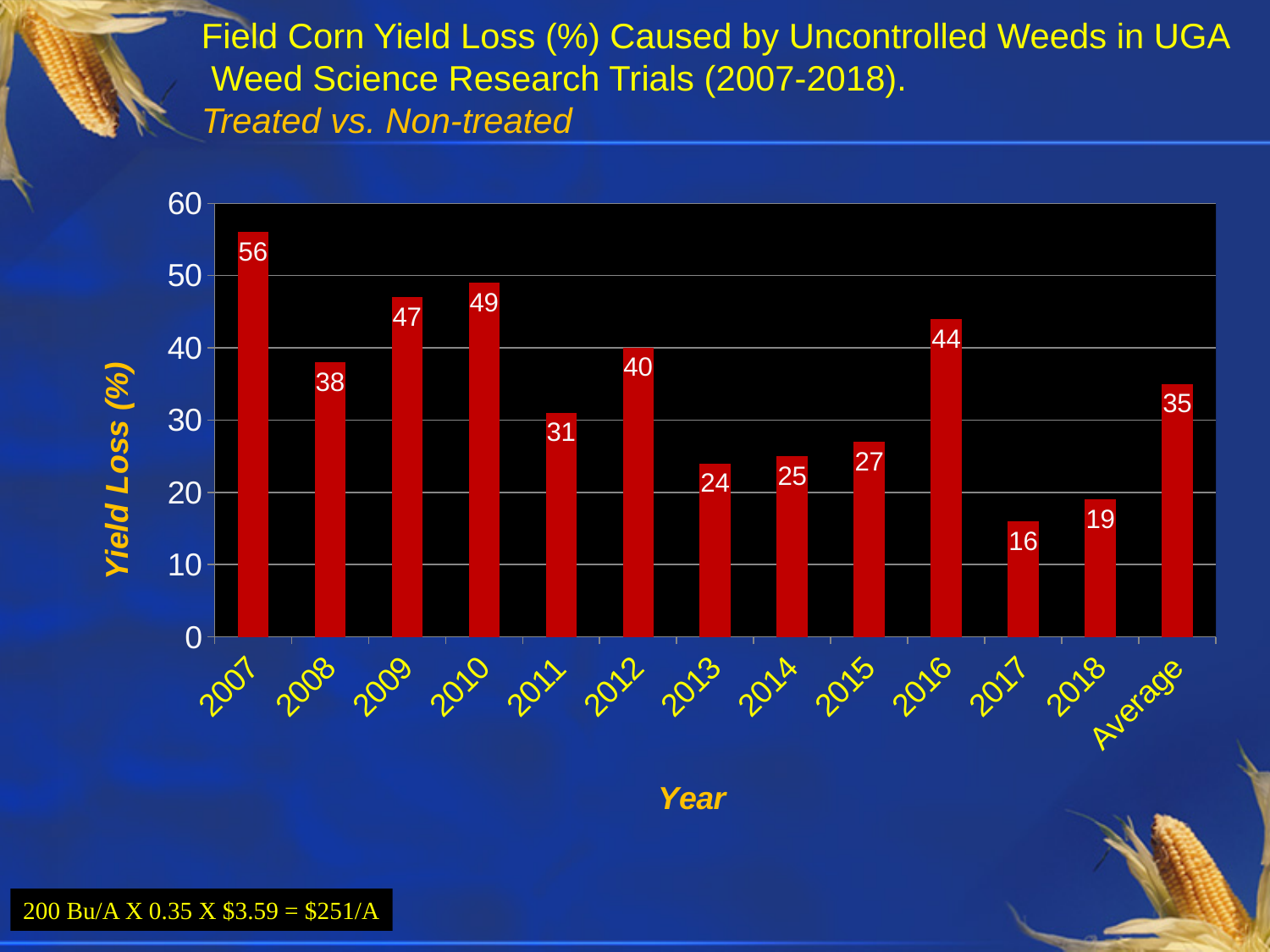
What type of chart is shown on the slide? Bar chart What is the yield loss (%) for 2007? 56 How many bars are shown in the chart? 13 Which year has the lowest yield loss? 2017 What is the label of the y axis? Yield Loss (%) What is the difference in yield loss between 2007 and 2017? 40 Is the yield loss for 2018 greater or less than 20? less Which year has a larger yield loss, 2009 or 2012? 2009 What is the Average yield loss (%) shown in the chart? 35 Which year has the highest yield loss? 2007 What is the yield loss (%) for 2016? 44 What is the difference in yield loss between 2010 and 2011? 18